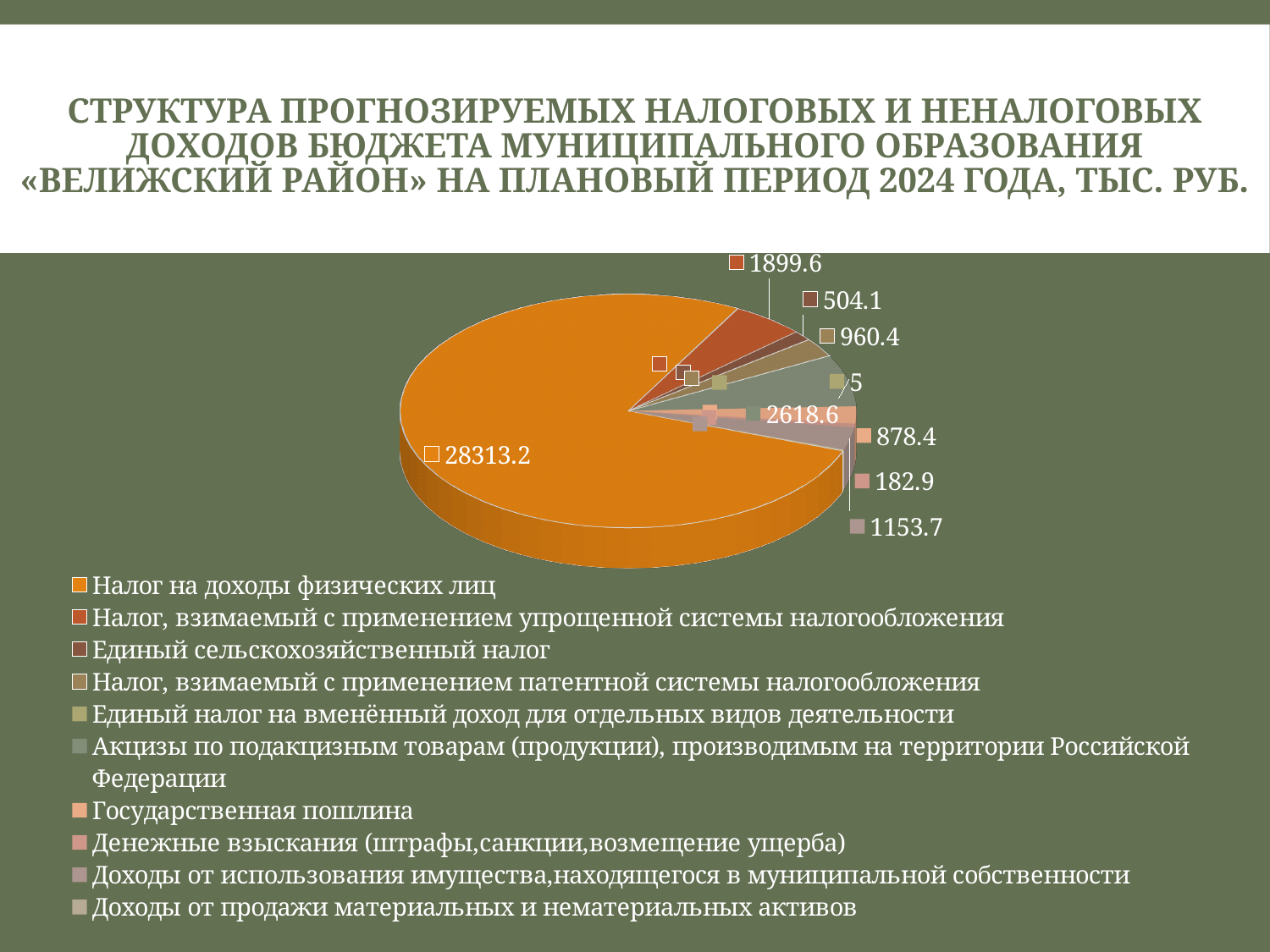
What kind of chart is shown on the slide? Pie chart What is the smallest value printed as a data label on the pie chart? 5 Which category has the largest slice of the pie? Налог на доходы физических лиц What is the difference between the value for «Налог на доходы физических лиц» (28313.2) and the value for «Акцизы по подакцизным товарам» (2618.6)? 25694.6 How many categories does the legend of the pie chart list? 10 What is the value shown for «Налог на доходы физических лиц»? 28313.2 Which is larger on the pie chart: the slice labelled 960.4 or the slice labelled 878.4? 960.4 In what units are the values on the chart given, according to the slide title? тыс. руб. What is the value shown for «Единый сельскохозяйственный налог»? 504.1 What is the value shown for «Налог, взимаемый с применением упрощенной системы налогообложения»? 1899.6 What is the difference between the data labels 1899.6 and 504.1 on the pie chart? 1395.5 What is the value shown for «Акцизы по подакцизным товарам (продукции), производимым на территории Российской Федерации»? 2618.6